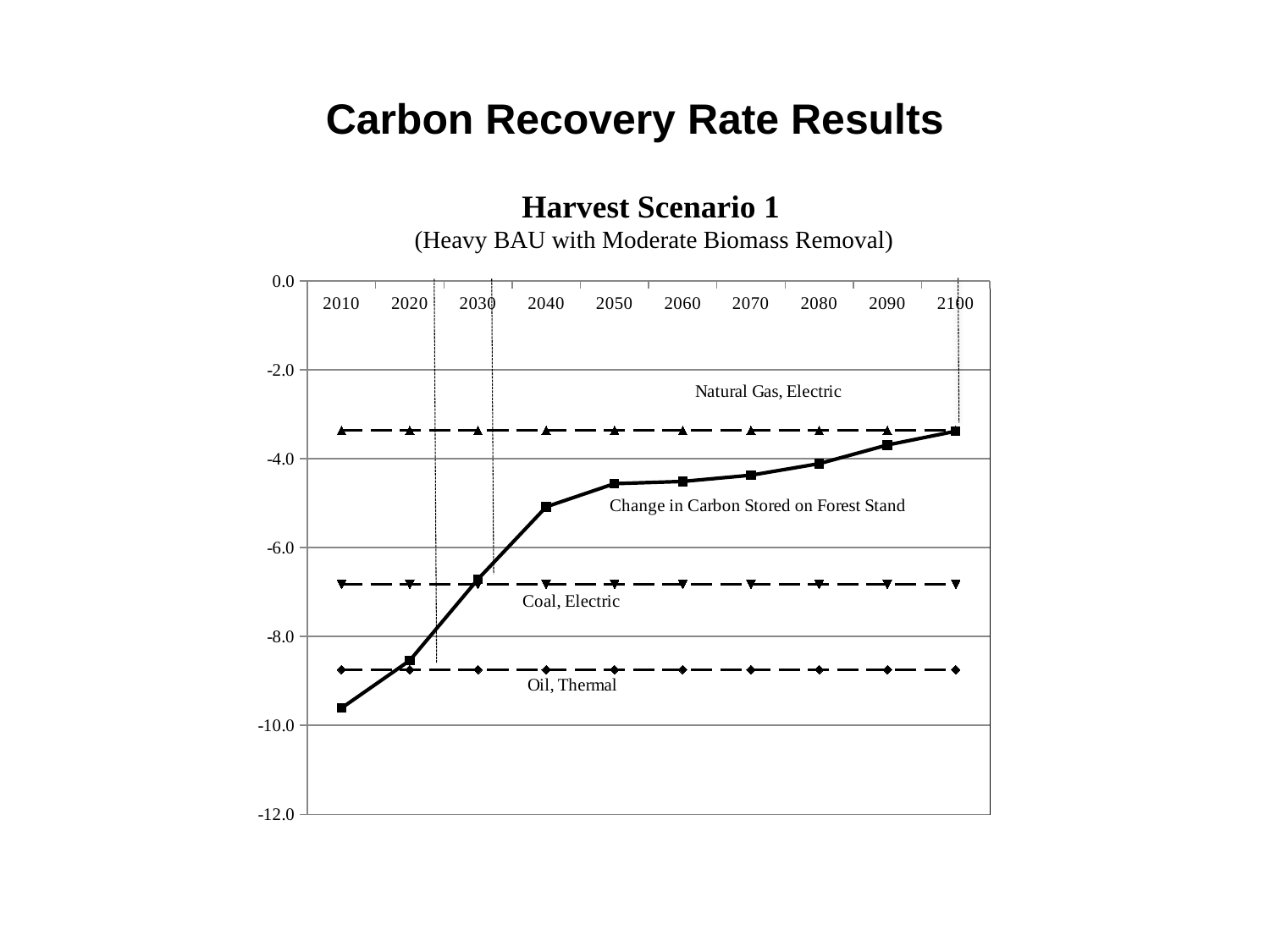
What is the subtitle shown in parentheses under "Harvest Scenario 1"? Heavy BAU with Moderate Biomass Removal Is the value of "Change in Carbon Stored on Forest Stand" in 2010 greater or less than -8.0? less Which of the three flat dashed series has the highest value? Natural Gas, Electric How many years are marked along the x axis of the chart? 10 Which series has the lowest value in 2010? Change in Carbon Stored on Forest Stand In 2040, which is larger: "Change in Carbon Stored on Forest Stand" or "Coal, Electric"? Change in Carbon Stored on Forest Stand Is the "Oil, Thermal" line greater or less than -8.0? less Is the "Natural Gas, Electric" line greater or less than -4.0? greater Does the "Change in Carbon Stored on Forest Stand" line rise or fall from 2010 to 2100? rise How many data series are plotted on the chart? 4 What kind of chart is shown under the title "Harvest Scenario 1"? line chart